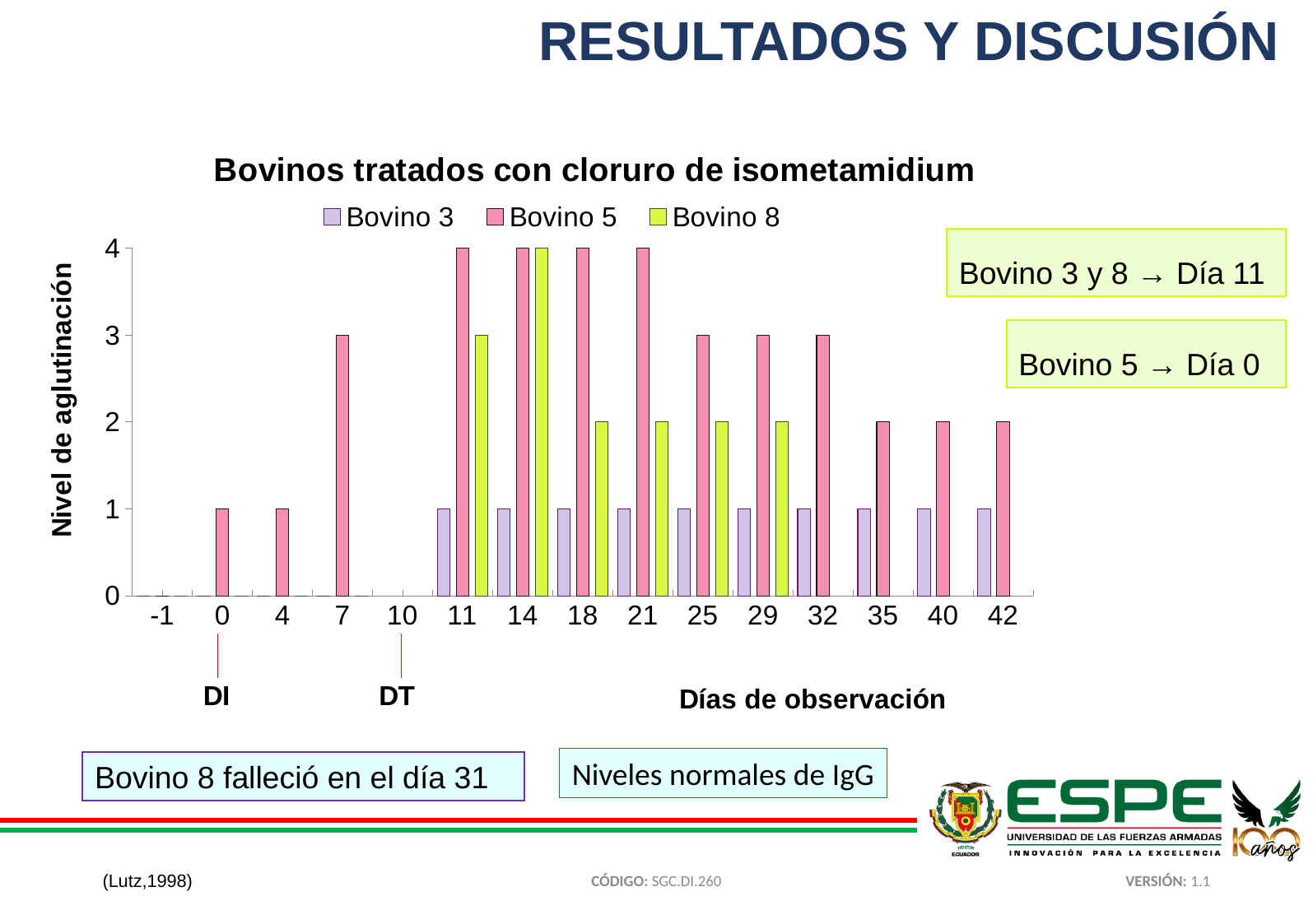
What is the agglutination level for Bovino 8 on day 11? 3 What is the agglutination level for Bovino 3 on day 14? 1 What is the agglutination level for Bovino 5 on day 7? 3 What is the label of the y axis? Nivel de aglutinación What is the difference between the agglutination levels of Bovino 5 and Bovino 3 on day 18? 3 What is the agglutination level for Bovino 5 on day 42? 2 Does the agglutination level for Bovino 5 rise or fall from day 21 to day 42? fall What is the title of the chart? Bovinos tratados con cloruro de isometamidium What kind of chart is shown on the slide? bar chart How many observation days (categories) are shown on the x axis? 15 On day 11, which has the higher agglutination level, Bovino 5 or Bovino 8? Bovino 5 How many series does the legend list? 3